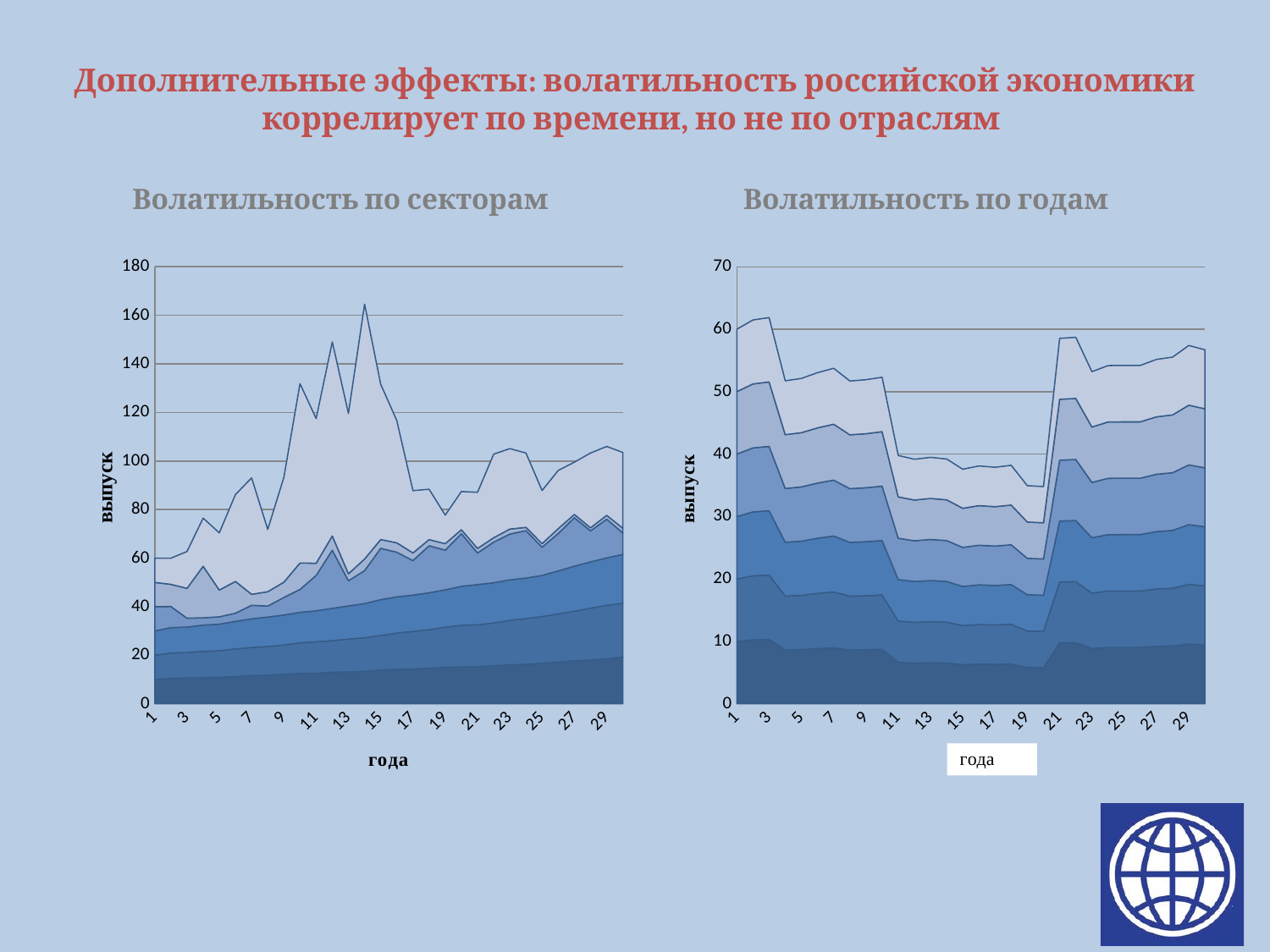
How many stacked series (bands) are plotted in the right chart "Волатильность по годам"? 6 In the right chart "Волатильность по годам", which has the larger total stacked value: year 20 or year 21? year 21 What kind of chart is the right chart titled "Волатильность по годам"? stacked area chart In the left chart "Волатильность по секторам", is the total stacked value at its highest peak (around year 14) greater or less than 140? greater In the left chart "Волатильность по секторам", which has the larger total stacked value: year 1 or year 14? year 14 What kind of chart is the left chart titled "Волатильность по секторам"? stacked area chart In the right chart "Волатильность по годам", is the total stacked value at year 20 greater or less than 40? less What is the title of the chart on the right side of the slide? Волатильность по годам In the left chart "Волатильность по секторам", does the bottom (darkest) series rise or fall from year 1 to year 30? rise In the right chart "Волатильность по годам", is the total stacked value at year 3 greater or less than 50? greater What label is shown on the vertical axis of the left chart? выпуск